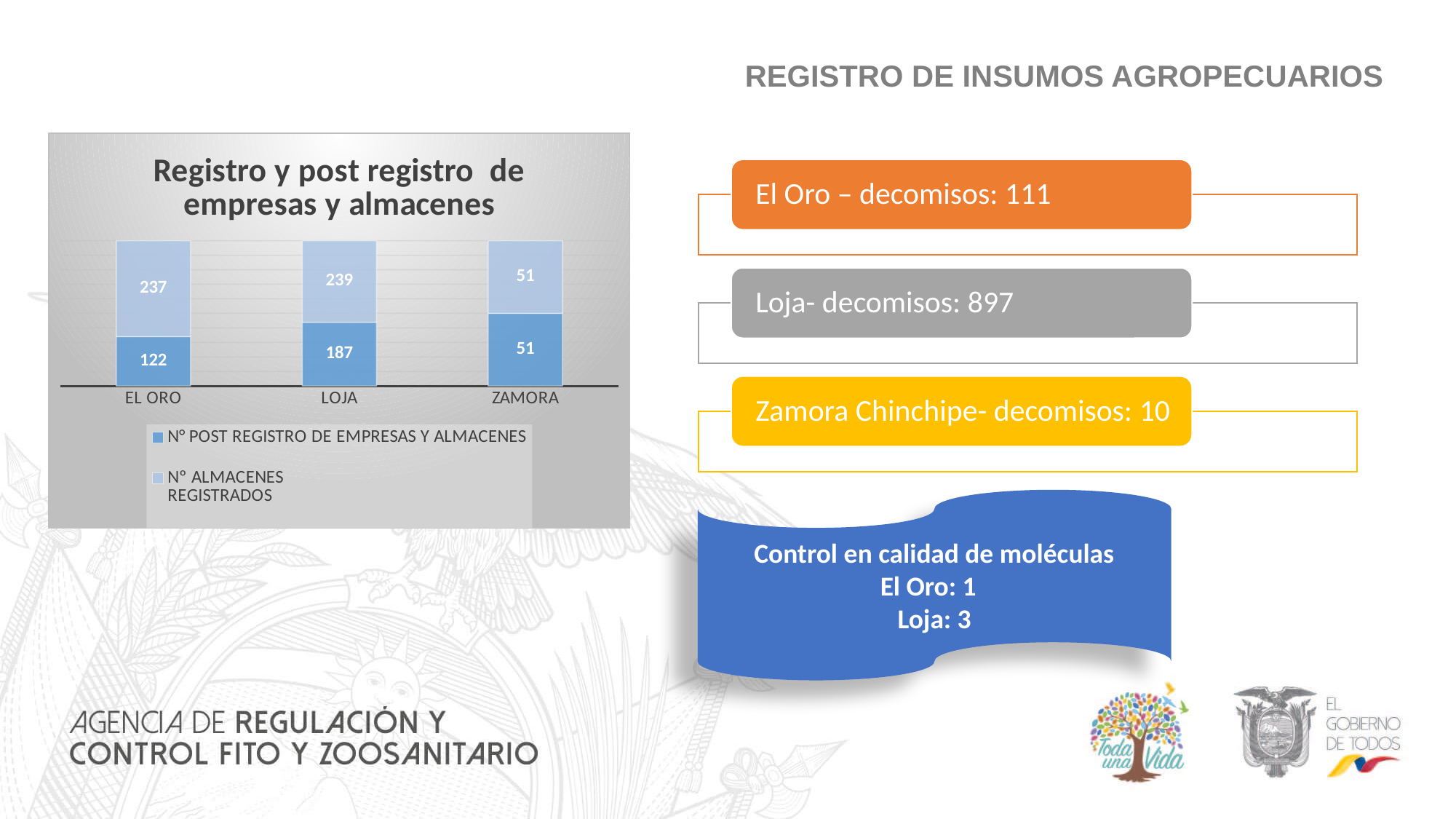
Which category has the lowest value for N° ALMACENES REGISTRADOS? ZAMORA How many categories are shown on the x axis of the chart? 3 What is the title of the chart? Registro y post registro de empresas y almacenes What is the value of N° POST REGISTRO DE EMPRESAS Y ALMACENES for LOJA? 187 How many series does the chart legend list? 2 What is the value of N° ALMACENES REGISTRADOS for EL ORO? 237 What kind of chart is shown on the slide? Stacked bar chart Which category has the highest value for N° POST REGISTRO DE EMPRESAS Y ALMACENES? LOJA What is the difference between the N° POST REGISTRO DE EMPRESAS Y ALMACENES values for LOJA and EL ORO? 65 What is the value of N° ALMACENES REGISTRADOS for ZAMORA? 51 What is the total of the stacked bar for LOJA? 426 Which is larger for EL ORO: N° POST REGISTRO DE EMPRESAS Y ALMACENES or N° ALMACENES REGISTRADOS? N° ALMACENES REGISTRADOS